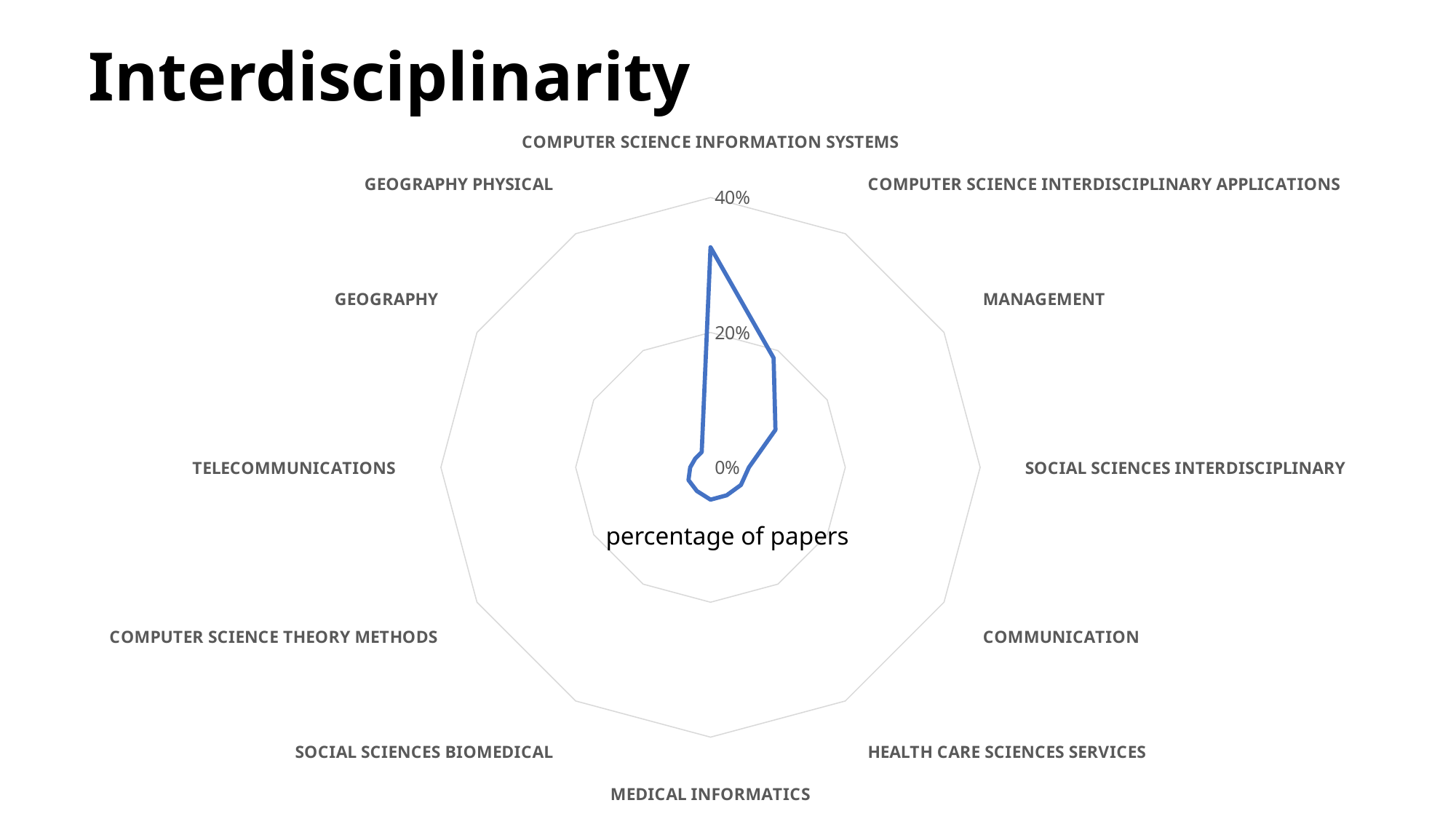
What kind of chart is shown on the slide? Radar chart What is the highest value labelled on the chart's radial axis? 40% Which category has the highest percentage of papers? COMPUTER SCIENCE INFORMATION SYSTEMS Is the value for COMPUTER SCIENCE INFORMATION SYSTEMS greater or less than 40%? less Which has a larger percentage of papers, COMPUTER SCIENCE INTERDISCIPLINARY APPLICATIONS or MEDICAL INFORMATICS? COMPUTER SCIENCE INTERDISCIPLINARY APPLICATIONS Which has a larger percentage of papers, COMPUTER SCIENCE INFORMATION SYSTEMS or MANAGEMENT? COMPUTER SCIENCE INFORMATION SYSTEMS Is the value for COMPUTER SCIENCE INFORMATION SYSTEMS greater or less than 20%? greater Is the value for TELECOMMUNICATIONS greater or less than 20%? less How many categories are plotted on the radar chart? 12